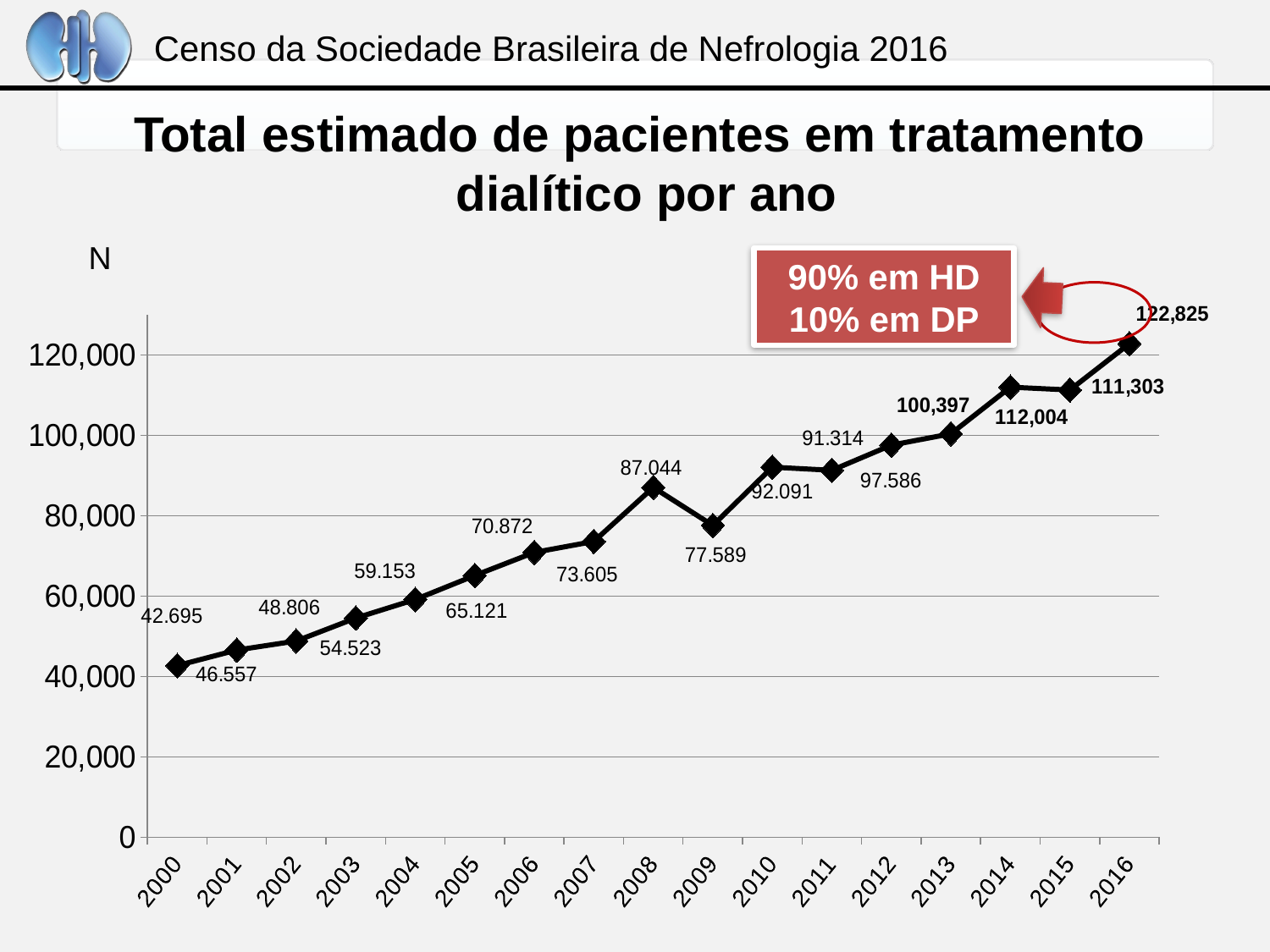
What is the difference between the values for 2016 and 2015? 11,522 Which year has the highest value on the chart? 2016 What type of chart is shown on the slide? line chart Which year has the lowest value on the chart? 2000 What is the estimated total of patients in dialysis treatment in 2016? 122,825 What does the red annotation box on the chart say? 90% em HD 10% em DP Which year has the larger value, 2008 or 2009? 2008 Is the value for 2012 greater or less than 100,000? less What is the value plotted for the year 2008? 87.044 How many years are plotted on the x axis? 17 What is the value plotted for the year 2000? 42.695 What is the value plotted for the year 2013? 100,397